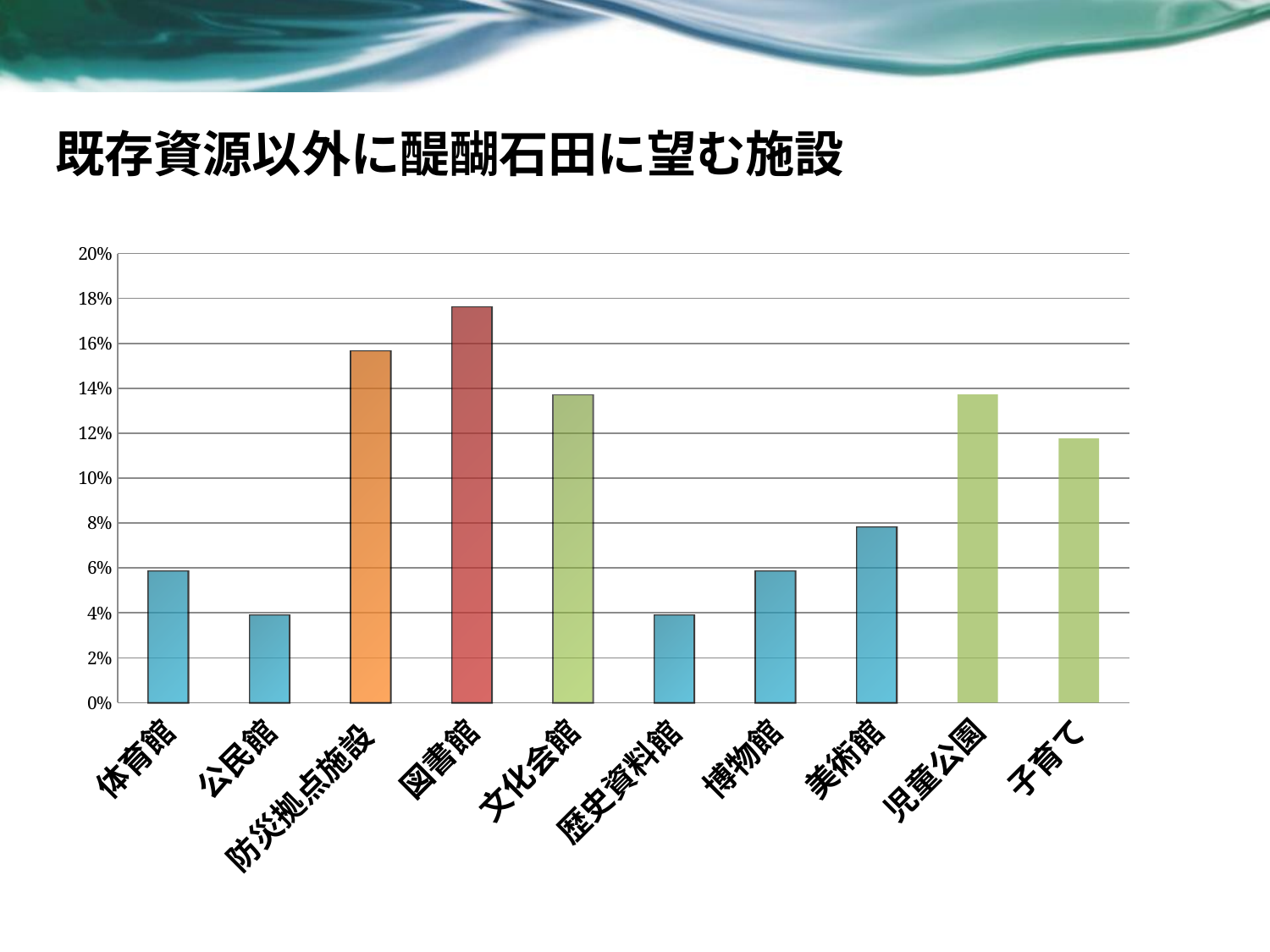
Which is larger, the value for 防災拠点施設 or the value for 文化会館? 防災拠点施設 Which is larger, the value for 児童公園 or the value for 子育て? 児童公園 Which is larger, the value for 美術館 or the value for 博物館? 美術館 What kind of chart is shown on the slide? bar chart Is the value for 図書館 greater or less than 16%? greater How many categories are shown on the x axis of the chart? 10 Is the value for 美術館 greater or less than 10%? less Is the value for 防災拠点施設 greater or less than 14%? greater What is the title of the chart on the slide? 既存資源以外に醍醐石田に望む施設 Which category has the highest value in the chart? 図書館